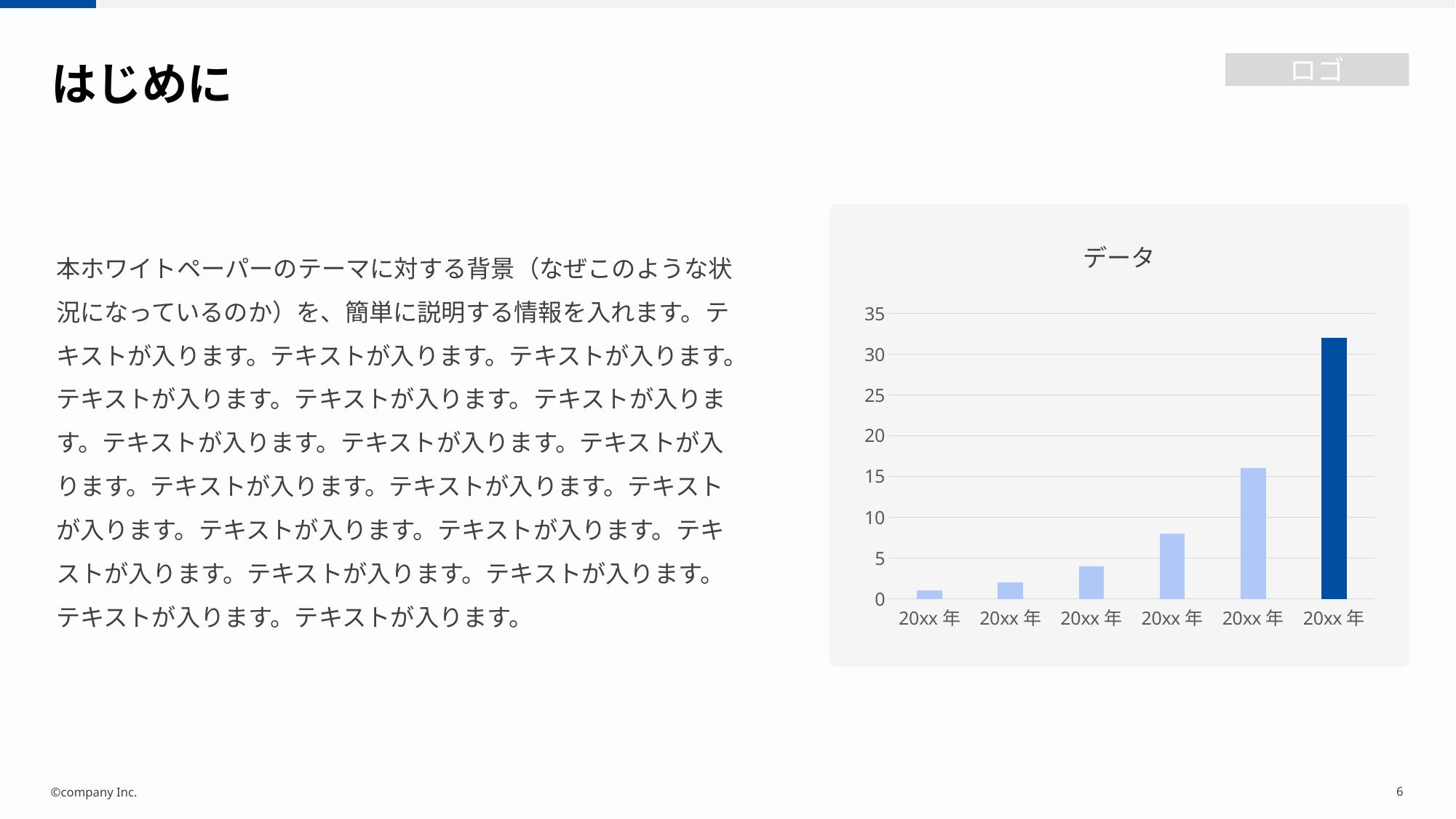
Which bar is the highest in the chart? the rightmost (sixth) bar What kind of chart is shown on the slide? bar chart What is the title of the chart? データ How many bars does the chart have? 6 What is the highest value shown on the vertical axis? 35 Is the value of the fifth bar from the left greater or less than 20? less Is the value of the second bar from the left greater or less than 5? less Do the bar values rise or fall from left to right along the x axis? rise Is the value of the rightmost bar greater or less than 30? greater Which is larger, the fifth bar from the left or the rightmost bar? the rightmost bar Which bar is the lowest in the chart? the leftmost (first) bar